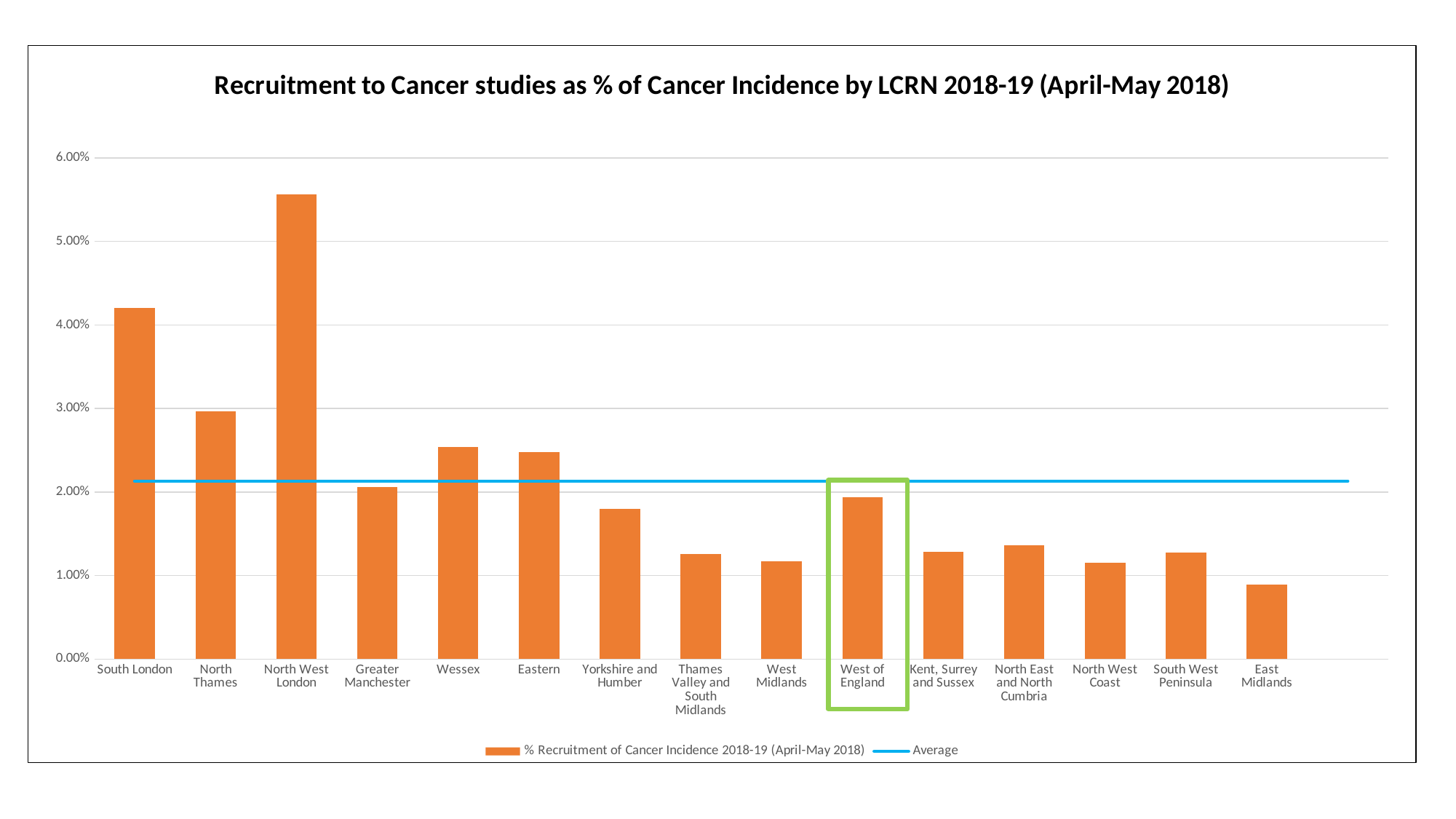
Which LCRN is highlighted with a green box on the chart? West of England Is the value for Yorkshire and Humber greater or less than 2.00%? less How many LCRNs are shown on the x axis? 15 Which LCRN has the highest recruitment as % of cancer incidence? North West London Which is larger, the value for South London or the value for North Thames? South London How many entries does the legend list? 2 Is the value for South London greater or less than 4.00%? greater Which LCRN has the lowest recruitment as % of cancer incidence? East Midlands Is the value for North West London greater or less than 5.00%? greater What kind of chart is shown on the slide? Bar chart Which is larger, the value for West of England or the value for West Midlands? West of England